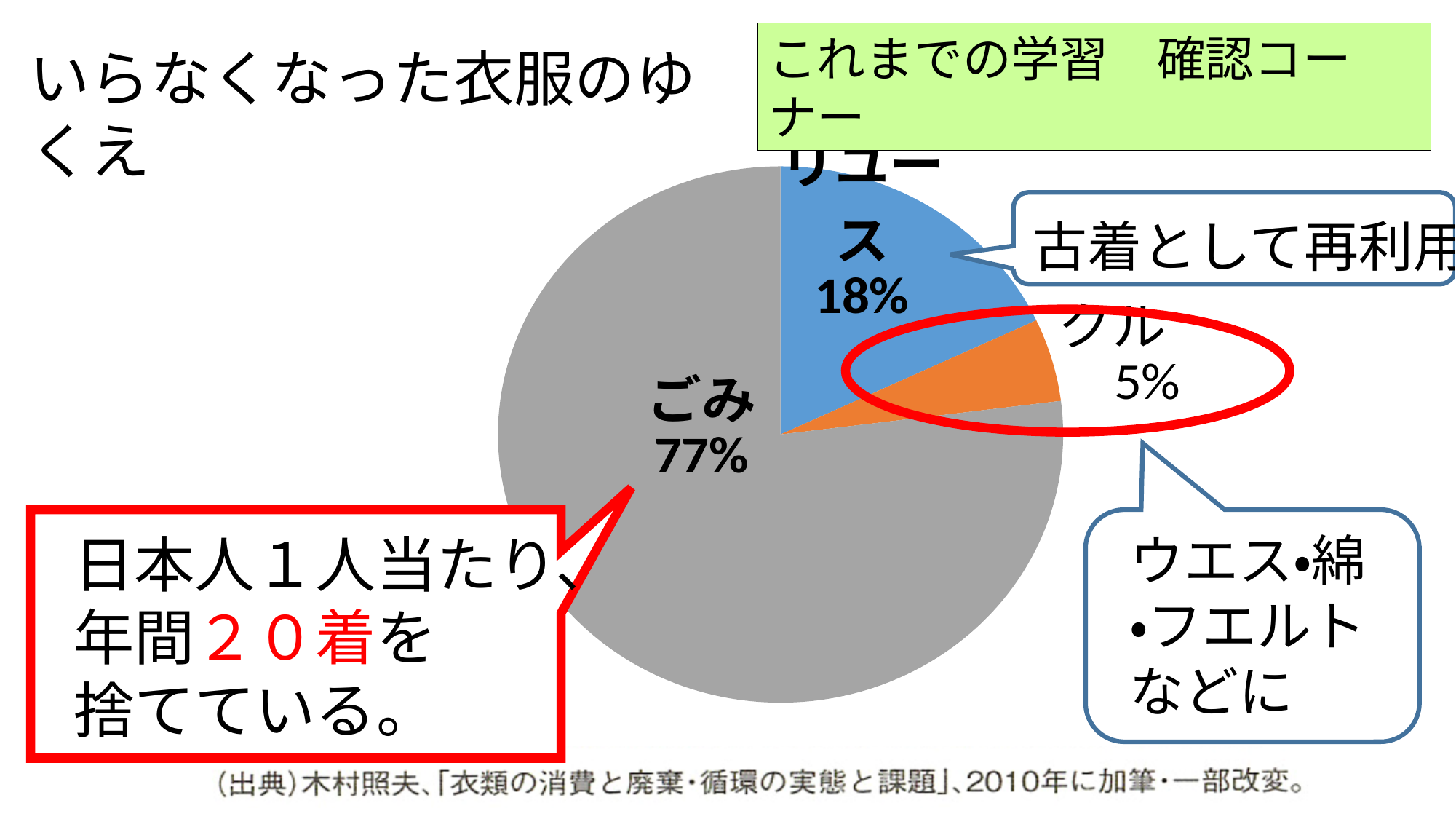
What percentage is shown on the orange slice of the pie chart? 5% What percentage is shown on the blue slice of the pie chart? 18% Which slice of the pie chart is the smallest? the orange slice (5%) Which is larger, the ごみ slice or the blue slice? ごみ What colour is the ごみ slice of the pie chart? grey What kind of chart is shown on the slide? pie chart How many slices does the pie chart have? 3 What percentage of the pie chart is labelled ごみ? 77% Which slice of the pie chart is the largest? ごみ What is the difference in percentage points between the ごみ slice and the blue slice? 59 Which slice of the pie chart is circled in red? the orange 5% slice What is the difference in percentage points between the blue slice and the orange slice? 13